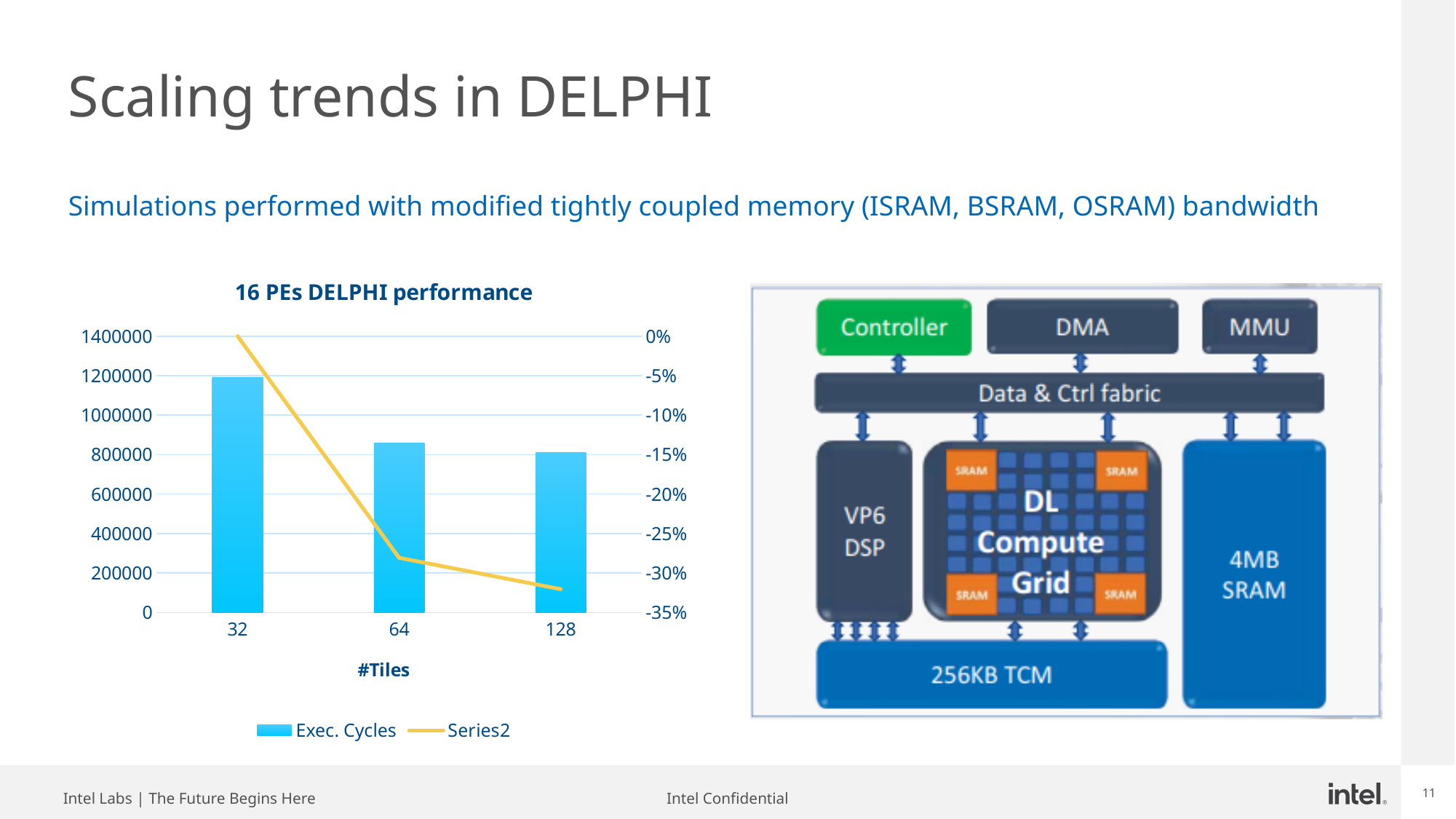
What are the two legend entries in the "16 PEs DELPHI performance" chart? Exec. Cycles and Series2 Which tile count has the lowest Exec. Cycles bar in the "16 PEs DELPHI performance" chart? 128 In the "16 PEs DELPHI performance" chart, is the Exec. Cycles value for 64 tiles greater or less than 1000000? less In the "16 PEs DELPHI performance" chart, which has the larger Exec. Cycles value: 32 tiles or 64 tiles? 32 tiles What type of chart is the "16 PEs DELPHI performance" chart? A bar chart with a line series How many tile counts are plotted on the x axis of the "16 PEs DELPHI performance" chart? 3 Which tile count has the highest Exec. Cycles bar in the "16 PEs DELPHI performance" chart? 32 Do the Exec. Cycles bars rise or fall as the number of tiles increases in the "16 PEs DELPHI performance" chart? Fall In the "16 PEs DELPHI performance" chart, is the Exec. Cycles value for 32 tiles greater or less than 1000000? greater In the "16 PEs DELPHI performance" chart, is the Exec. Cycles value for 128 tiles greater or less than 600000? greater How many series does the legend of the "16 PEs DELPHI performance" chart list? 2 What is the x-axis title of the "16 PEs DELPHI performance" chart? #Tiles